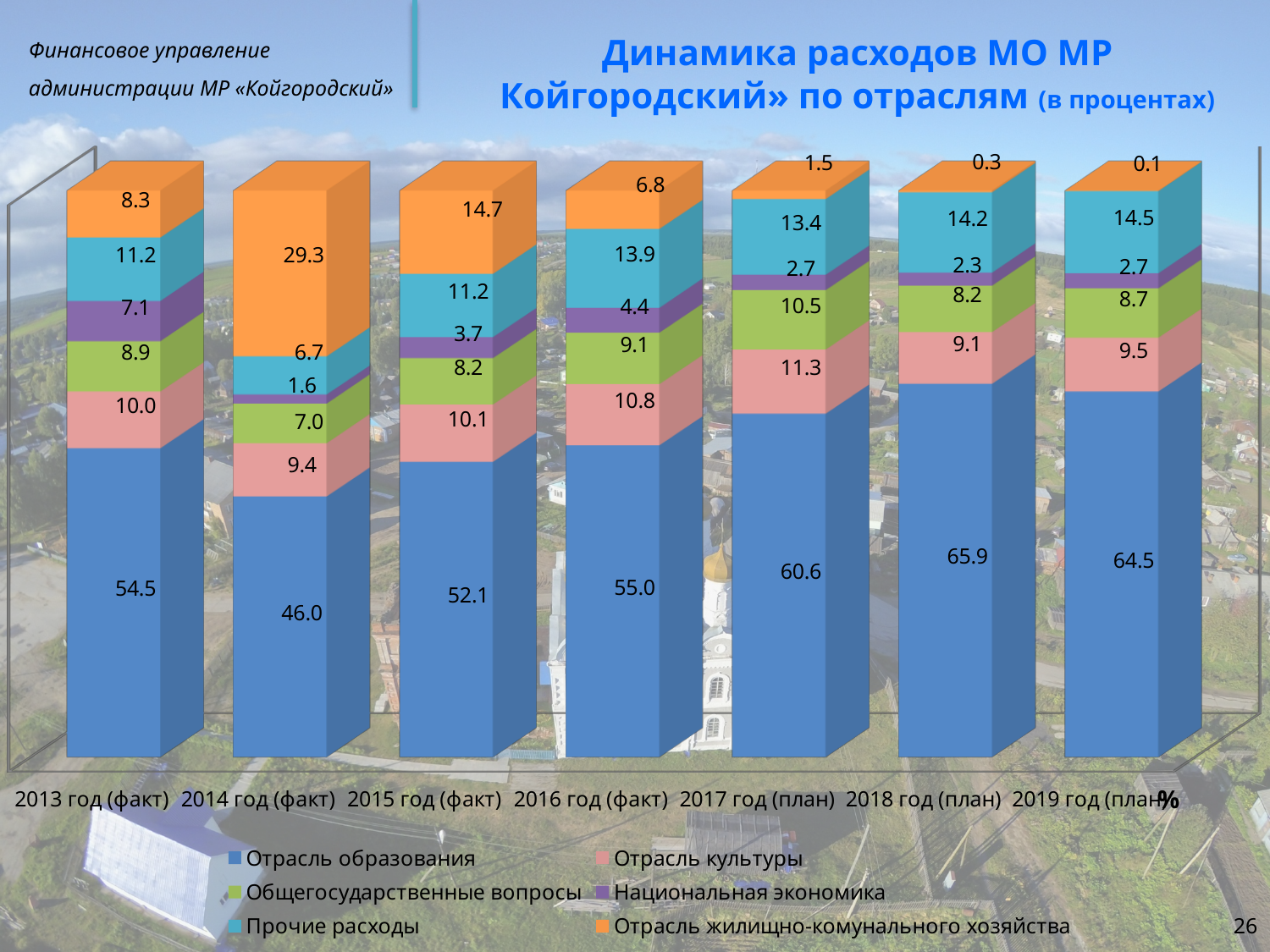
Which is larger: Отрасль культуры in 2017 год (план) or Отрасль культуры in 2015 год (факт)? 2017 год (план) What is the value for Отрасль жилищно-комунального хозяйства in 2014 год (факт)? 29.3 What is the difference between the Отрасль образования values for 2018 год (план) and 2014 год (факт)? 19.9 How many series does the legend list? 6 How many years (categories) are shown on the x axis? 7 What is the value for Отрасль образования in 2013 год (факт)? 54.5 What is the value for Национальная экономика in 2016 год (факт)? 4.4 In which year is the value for Отрасль жилищно-комунального хозяйства the lowest? 2019 год (план) In which year is the value for Отрасль образования the highest? 2018 год (план) Does the value for Отрасль жилищно-комунального хозяйства rise or fall from 2014 год (факт) to 2019 год (план)? Fall What kind of chart is shown on the slide? Stacked bar chart What is the value for Прочие расходы in 2019 год (план)? 14.5